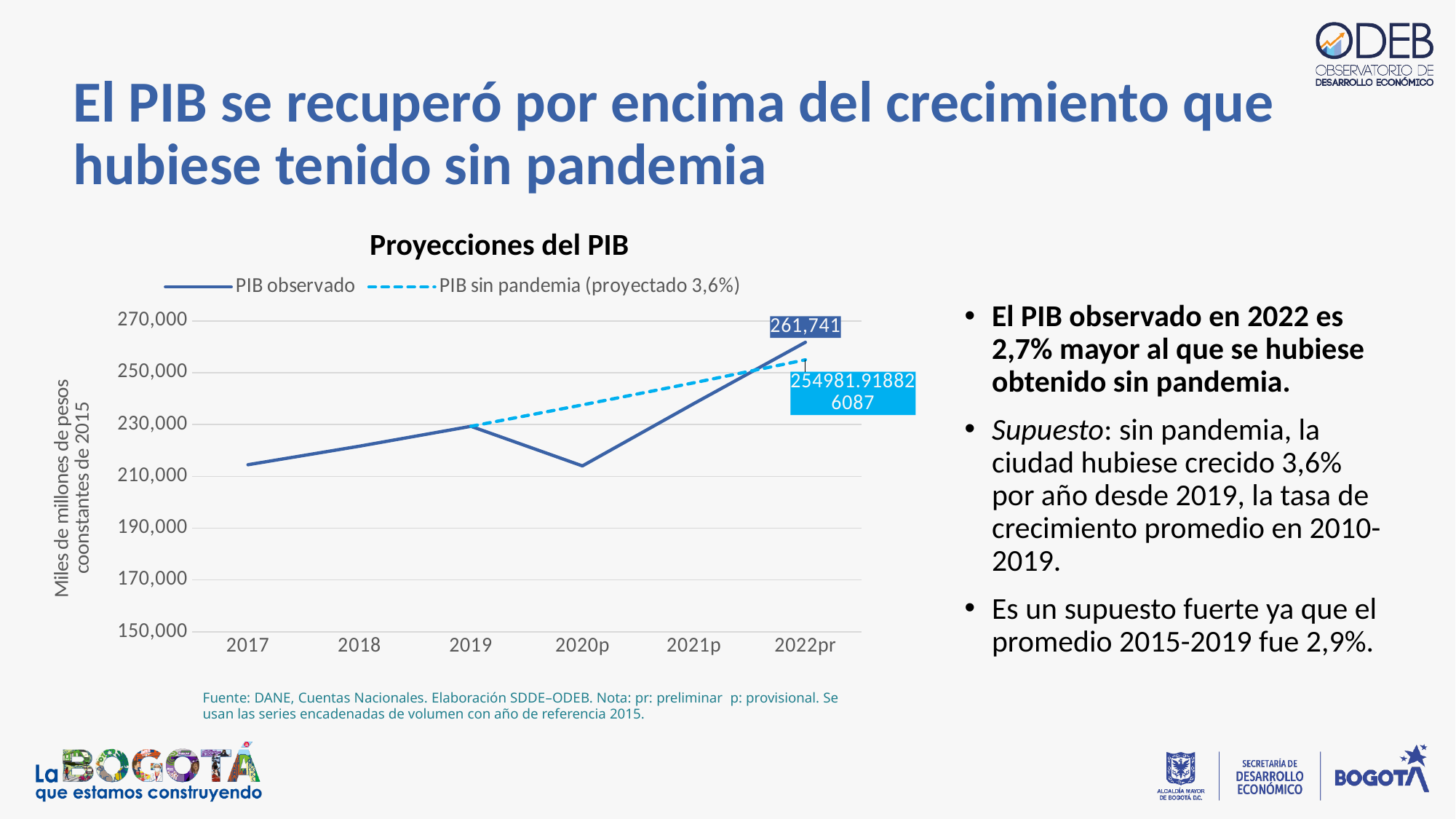
What is the value of PIB sin pandemia (proyectado 3,6%) for 2022pr? 254981.918826087 How many series does the legend of the chart list? 2 Is the value of PIB observado for 2021p greater or less than 230,000? greater Is the value of PIB observado for 2017 greater or less than 210,000? greater What is the title of the chart? Proyecciones del PIB In which year does PIB observado reach its highest value? 2022pr What is the value of PIB observado for 2022pr? 261,741 In 2022pr, which is larger: PIB observado or PIB sin pandemia (proyectado 3,6%)? PIB observado What kind of chart is shown on the slide? line chart Is the value of PIB observado for 2020p greater or less than 230,000? less How many years are shown on the x axis of the chart? 6 Does PIB observado rise or fall from 2019 to 2020p? fall